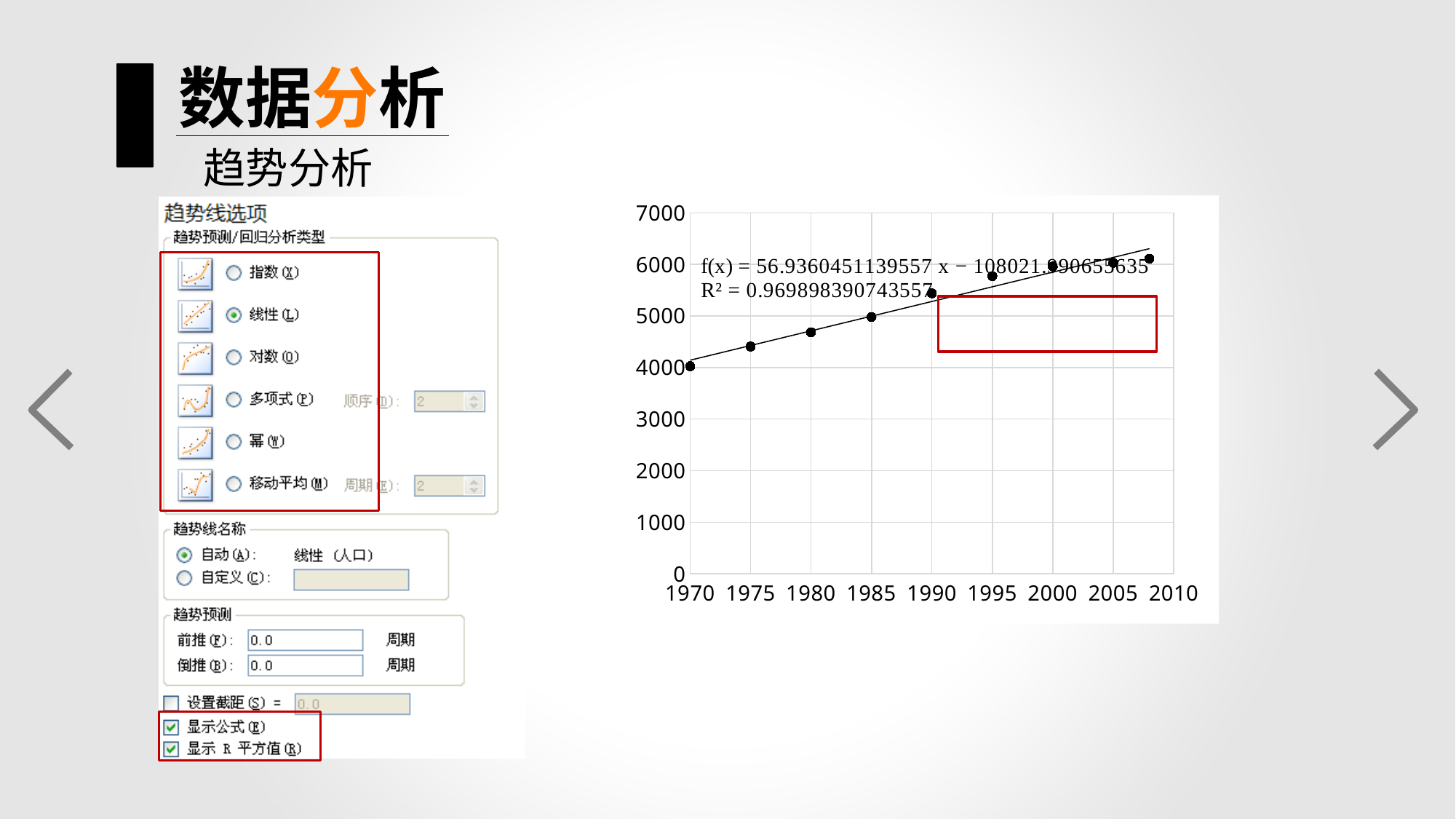
What kind of chart is shown on the right of the slide? scatter chart with a trendline Do the plotted values rise or fall as the year increases along the x axis? rise Which year has the lowest plotted value? 1970 Is the value for 1970 greater or less than 5000? less How many data points are plotted on the chart? 9 What is the highest tick label on the y axis? 7000 Which is larger, the value for 1990 or the value for 1975? 1990 Is the value for 1980 greater or less than 5000? less What R² value is printed on the chart? 0.969898390743557 Is the value for 2000 greater or less than 5000? greater